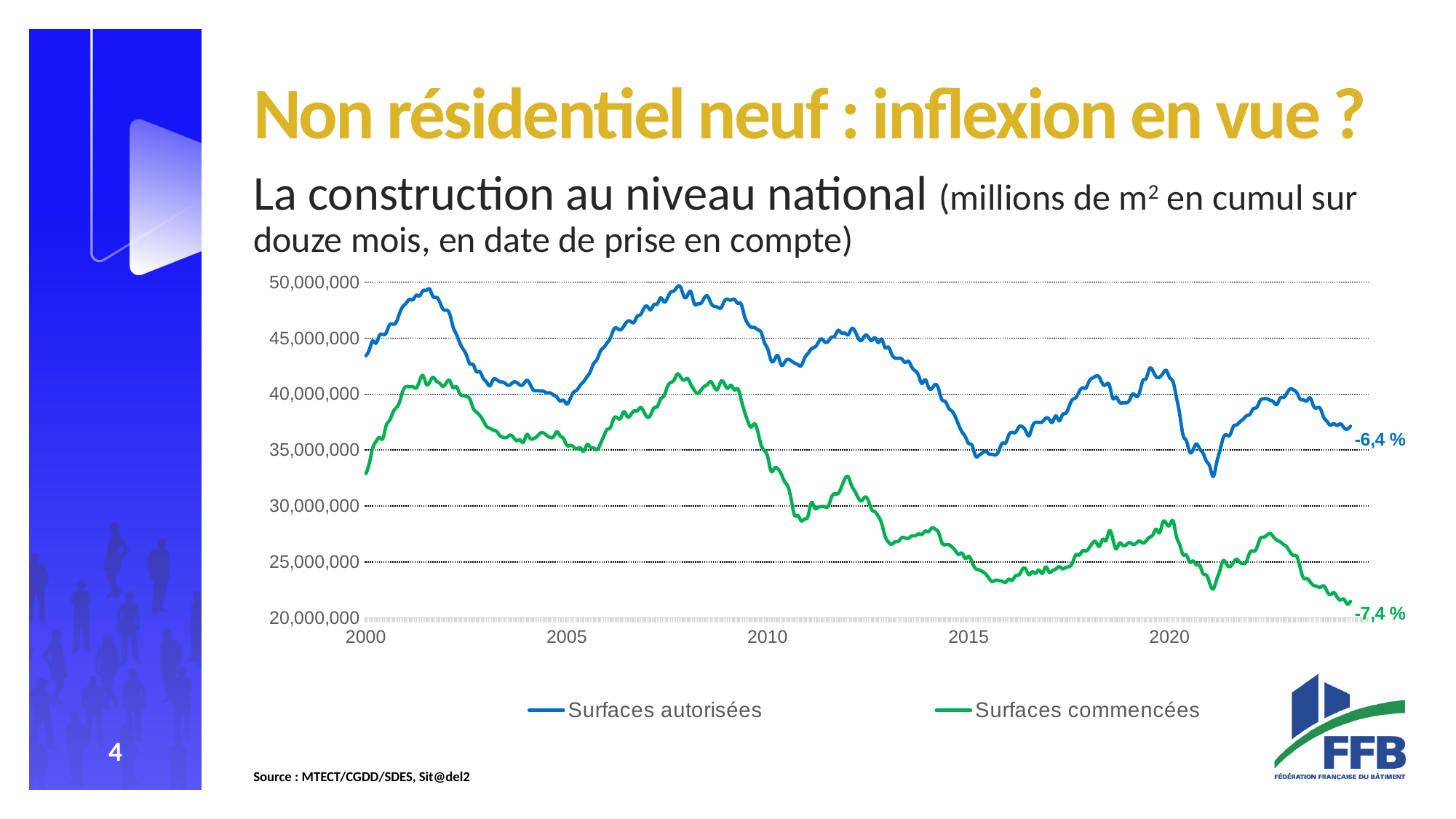
Is the value of Surfaces autorisées in 2000 greater or less than 40,000,000? greater Which series has the larger annotated decline at the end of the chart, Surfaces autorisées or Surfaces commencées? Surfaces commencées Which series is higher throughout the chart, Surfaces autorisées or Surfaces commencées? Surfaces autorisées What kind of chart is shown on the slide? line chart How many series does the legend list? 2 What percentage change is annotated at the end of the Surfaces autorisées line? -6,4 % Which series is drawn in green? Surfaces commencées What is the highest value shown on the vertical axis? 50,000,000 Does the Surfaces commencées line overall rise or fall between 2010 and 2015? fall Is the value of Surfaces autorisées at the end of the chart greater or less than 35,000,000? greater What percentage change is annotated at the end of the Surfaces commencées line? -7,4 % Is the value of Surfaces commencées at the end of the chart greater or less than 25,000,000? less